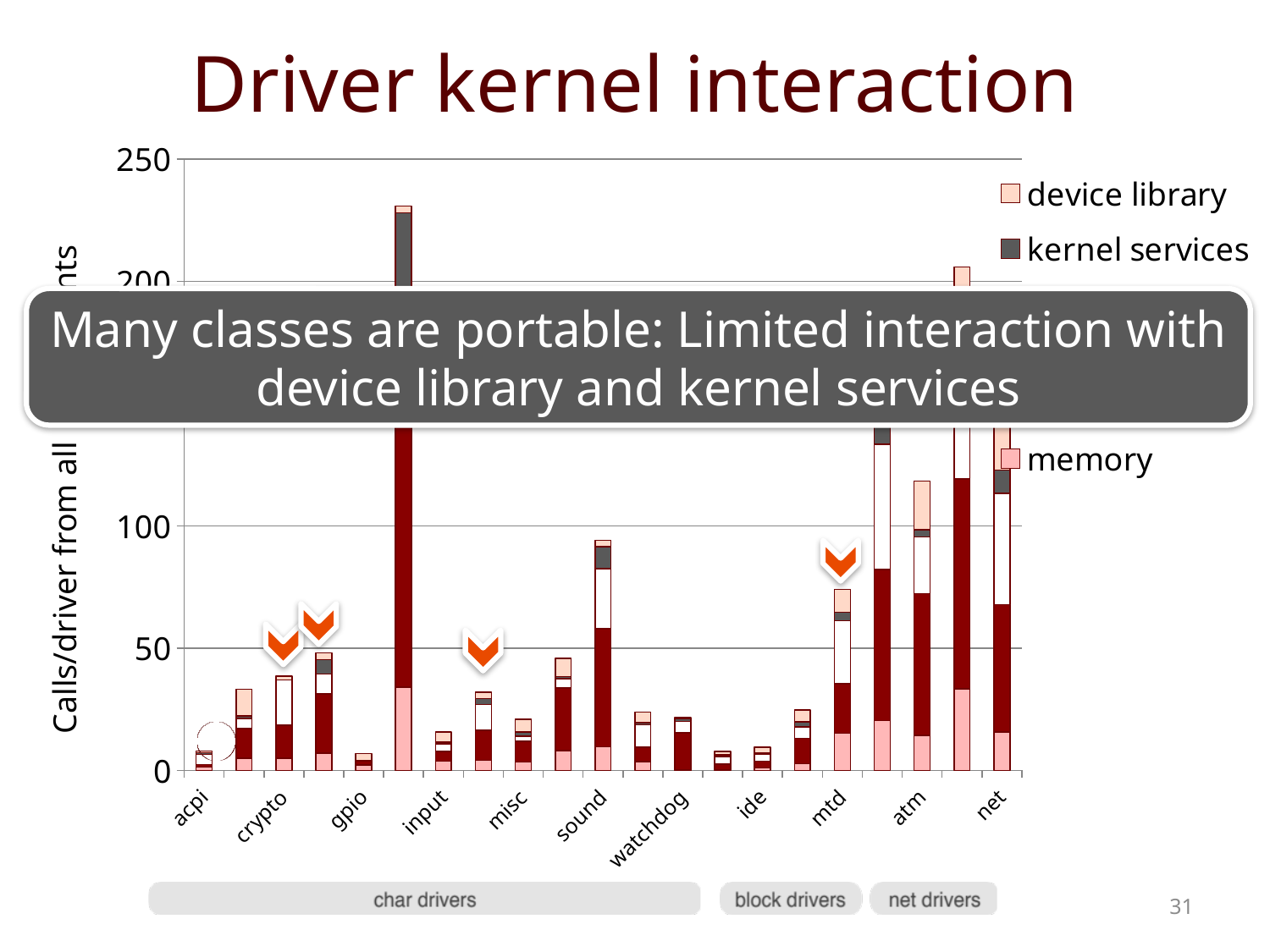
Is the total value for ide greater or less than 50? less Is the total value for mtd greater or less than 50? greater Which has a larger total value, sound or misc? sound What type of chart is shown on the slide? stacked bar chart Is the total value for sound greater or less than 100? less What is the title of the chart? Driver kernel interaction Which has a larger total value, crypto or gpio? crypto Which legend entry is listed first (at the top) in the chart legend? device library